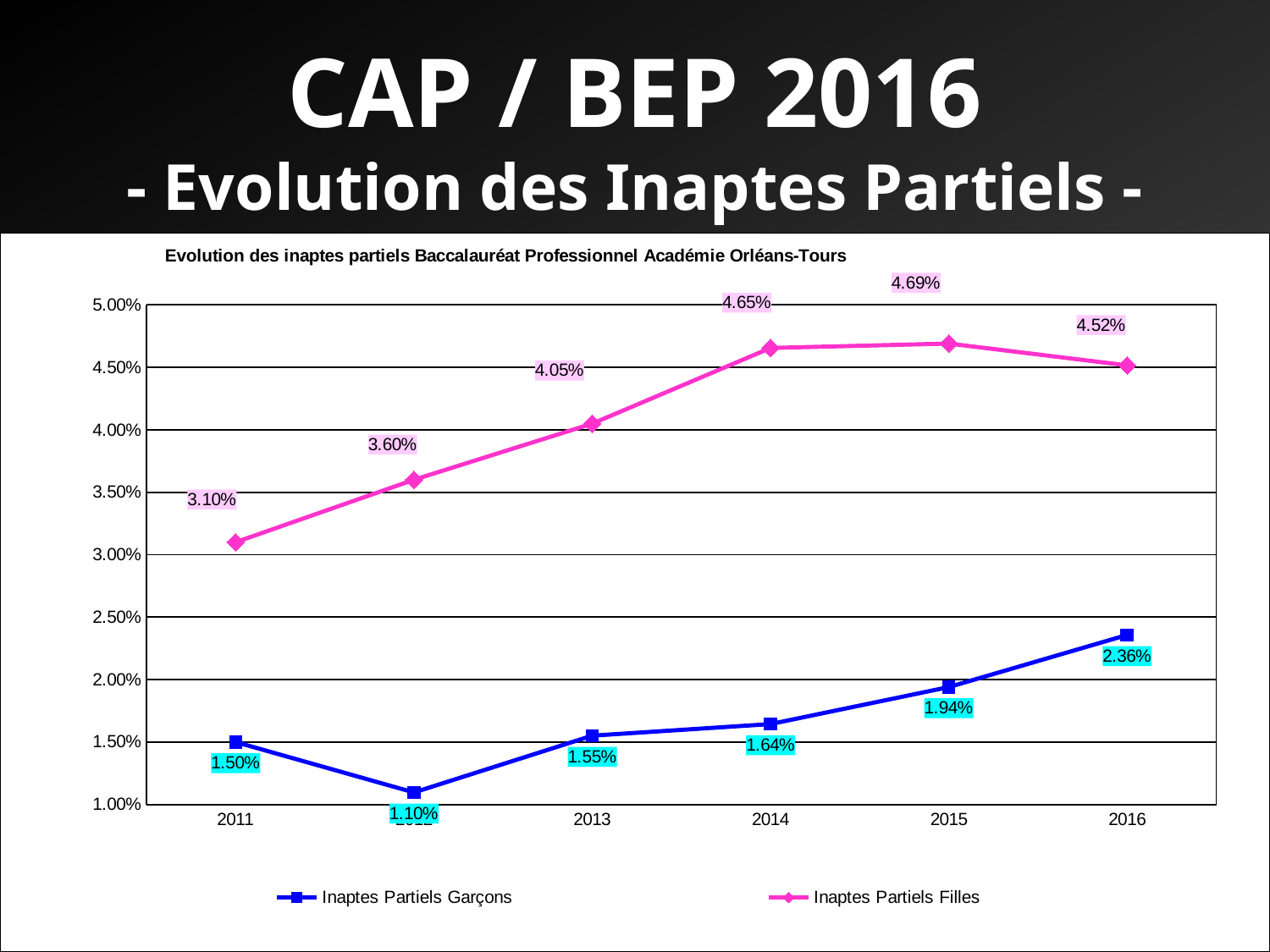
What kind of chart is shown on the slide? line chart How many years are plotted on the x axis? 6 What is the difference between Inaptes Partiels Filles and Inaptes Partiels Garçons in 2016? 2.16% What is the value for Inaptes Partiels Filles in 2015? 4.69% What is the value for Inaptes Partiels Filles in 2011? 3.10% In which year is the Inaptes Partiels Filles value highest? 2015 What is the value for Inaptes Partiels Garçons in 2016? 2.36% In 2014, which series has the larger value, Inaptes Partiels Garçons or Inaptes Partiels Filles? Inaptes Partiels Filles How many series does the legend list? 2 Is the value for Inaptes Partiels Garçons in 2015 greater or less than 2.00%? less In which year is the Inaptes Partiels Filles value lowest? 2011 By how much did Inaptes Partiels Garçons increase from 2011 to 2016? 0.86%